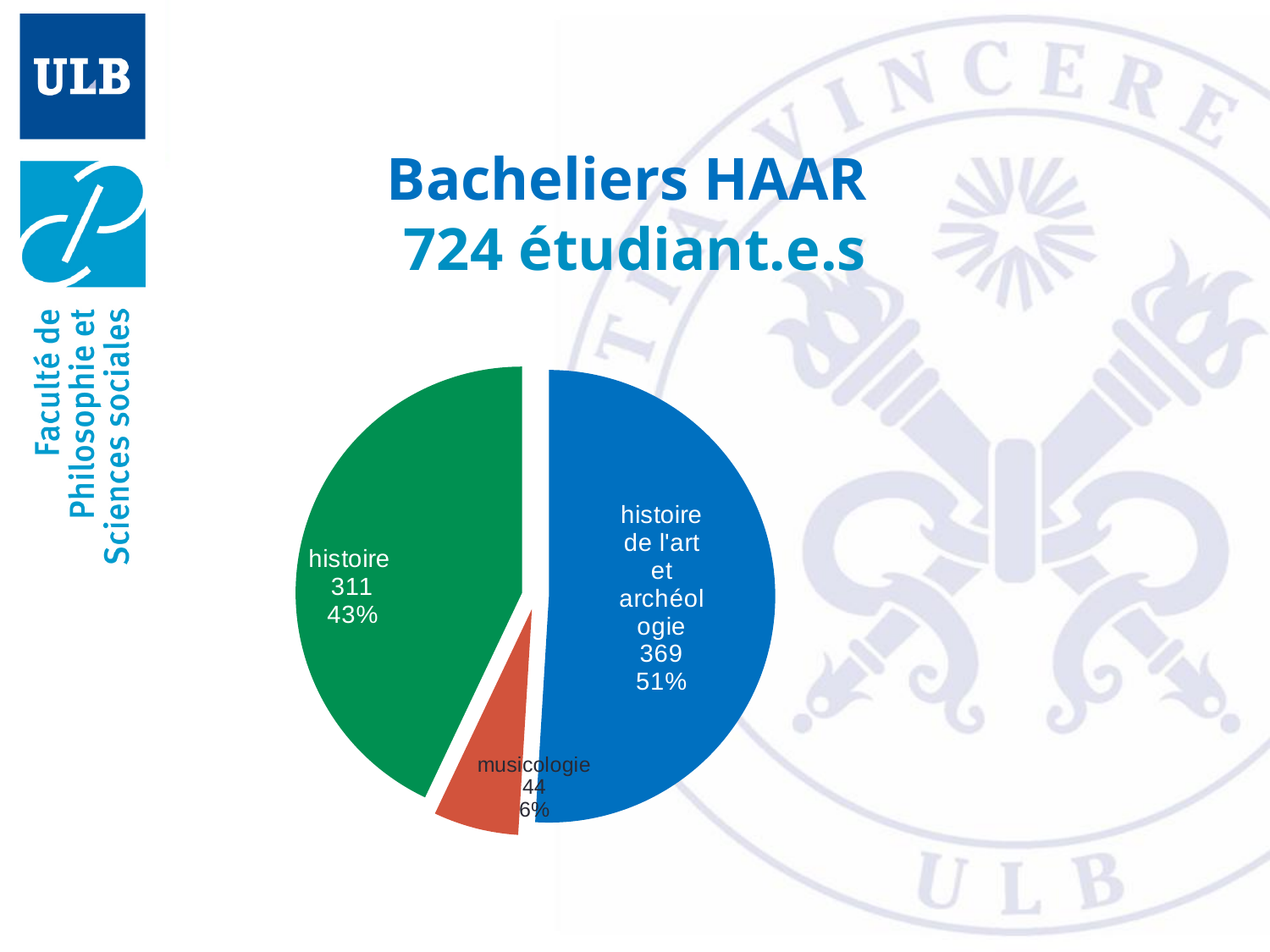
What kind of chart is shown on the slide? pie chart Which slice is the largest? histoire de l'art et archéologie Which has more students, histoire or musicologie? histoire How many students are in histoire? 311 What is the difference in students between histoire de l'art et archéologie and histoire? 58 What share of the pie does histoire represent? 43% What is the title of the slide above the chart? Bacheliers HAAR 724 étudiant.e.s How many students are in musicologie? 44 Which slice is the smallest? musicologie How many students are in histoire de l'art et archéologie? 369 What share of the pie does musicologie represent? 6% How many slices does the pie chart have? 3